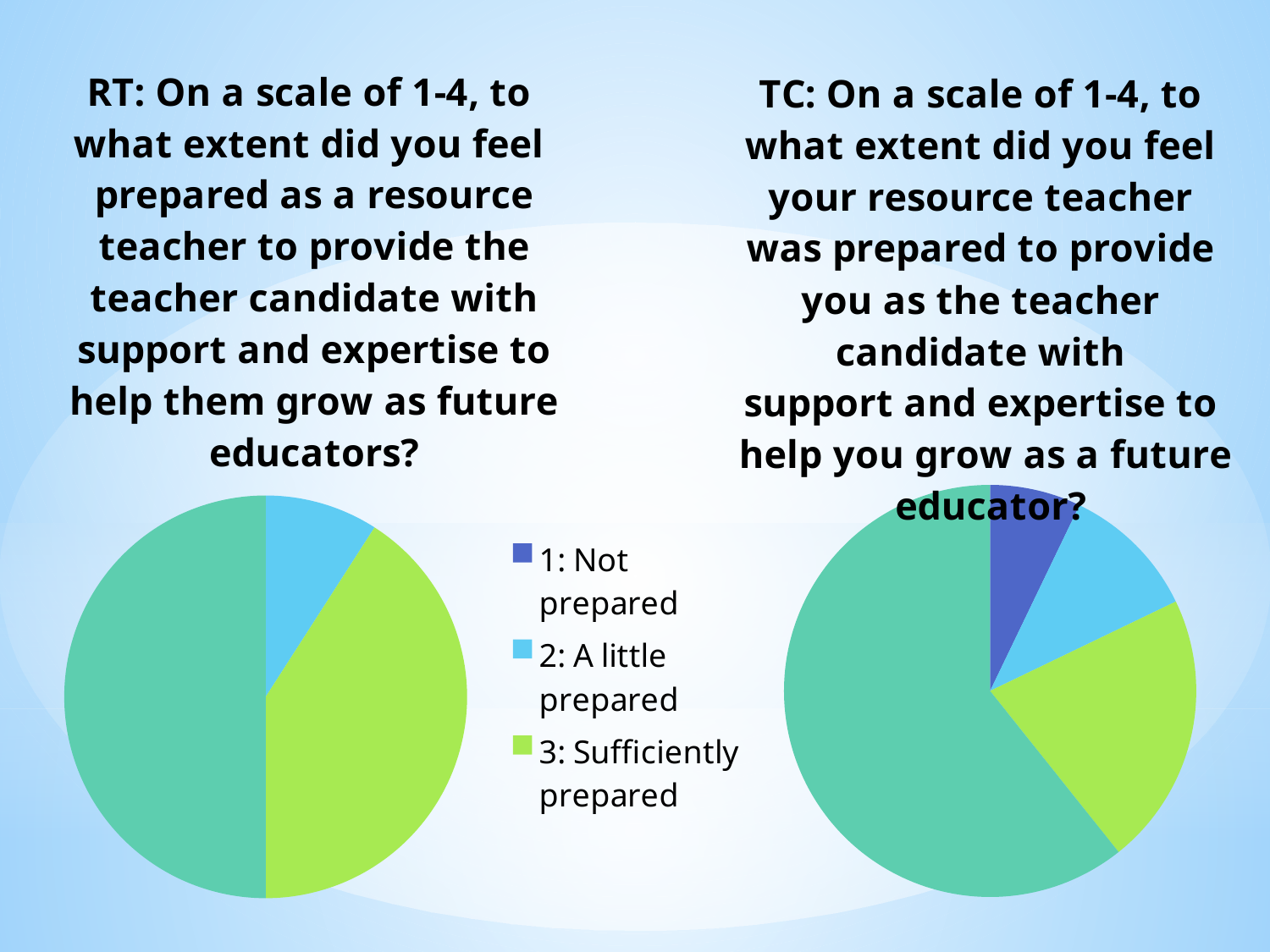
Which of the two pie charts contains a "1: Not prepared" slice? the TC chart on the right How many entries does the legend between the two charts list? 3 In the RT chart on the left, which slice is larger: "2: A little prepared" or "3: Sufficiently prepared"? 3: Sufficiently prepared What kind of chart is used on the right (TC) side of the slide? pie chart What colour represents "3: Sufficiently prepared" in the legend? green In the TC chart on the right, which of the legend categories has the smallest slice? 1: Not prepared In the TC chart on the right, which slice is larger: "2: A little prepared" or "3: Sufficiently prepared"? 3: Sufficiently prepared What kind of chart is used on the left (RT) side of the slide? pie chart